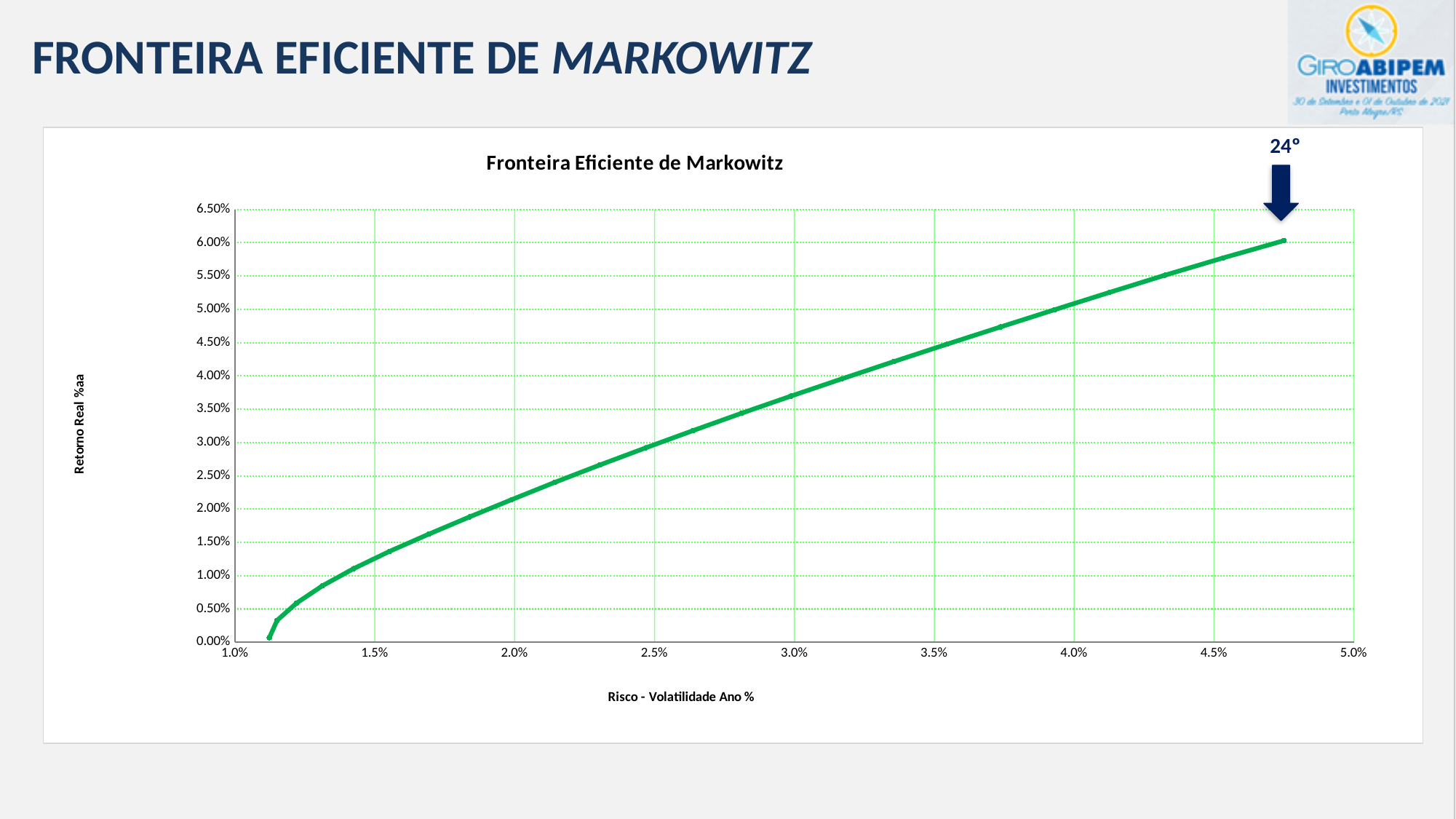
Is the return at a risk of 2.5% greater or less than 3.50%? less What kind of chart is shown on the slide? line chart What is the maximum value shown on the x axis of the chart? 5.0% Does the return (Retorno Real %aa) rise or fall as risk (volatility) increases along the x axis? rise Is the highest return reached by the curve greater or less than 6.50%? less What is the title of the chart? Fronteira Eficiente de Markowitz Is the return at a risk of 1.5% greater or less than 2.00%? less What is the label of the x axis of the chart? Risco - Volatilidade Ano %